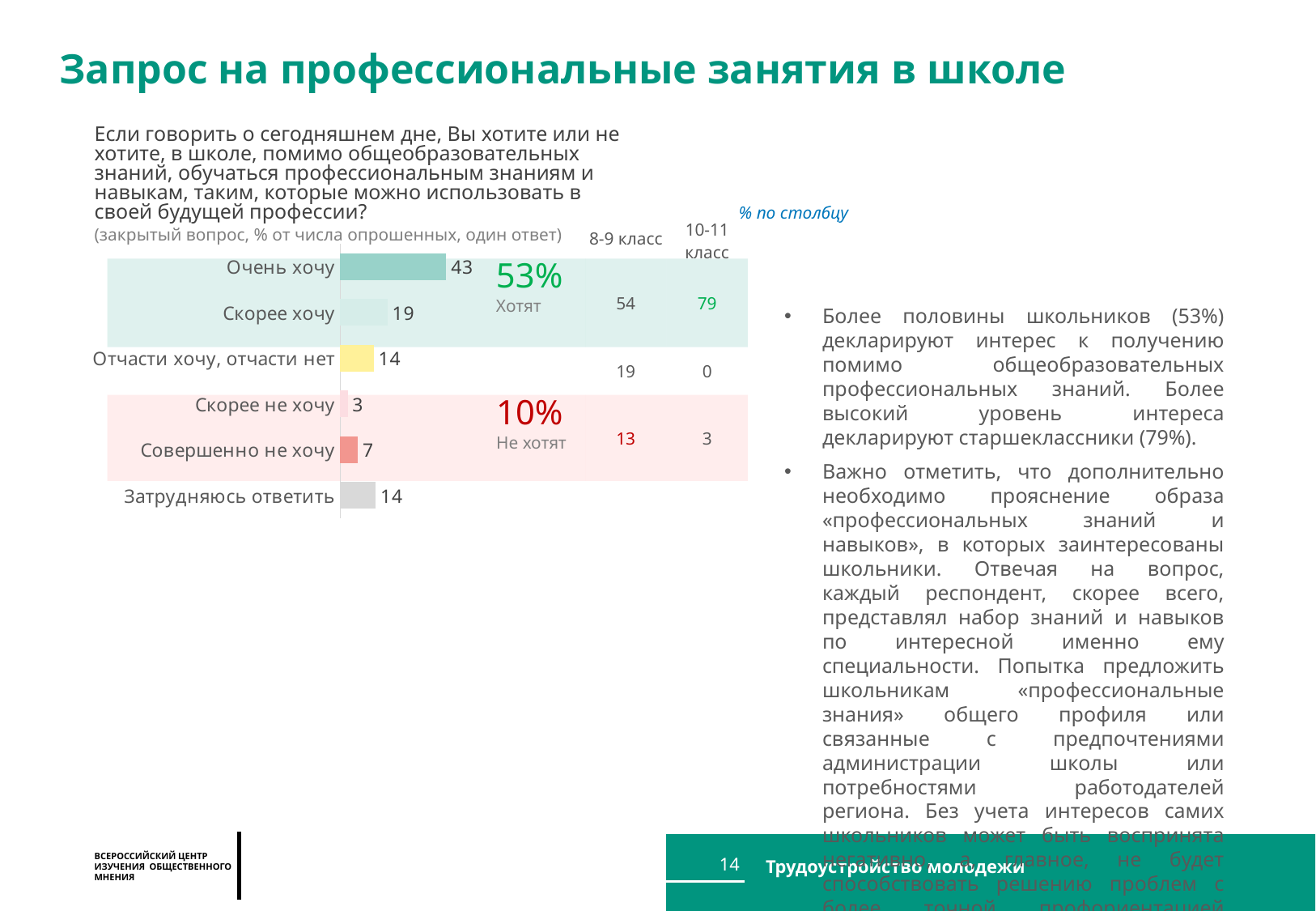
What value is shown for "Совершенно не хочу" in the bar chart? 7 Which category has the highest value in the bar chart? Очень хочу What is the combined share of respondents who want professional training ("Хотят") shown next to the chart? 53% How many categories are shown in the bar chart? 6 What kind of chart is shown on the slide? Bar chart Which category has the lowest value in the bar chart? Скорее не хочу Which is larger: the value for "Совершенно не хочу" or the value for "Скорее не хочу"? Совершенно не хочу What is the difference between the values for "Очень хочу" and "Скорее хочу"? 24 What value is shown for "Скорее хочу" in the bar chart? 19 In the table next to the chart, what is the "Хотят" value for 10-11 класс? 79 What value is shown for "Очень хочу" in the bar chart? 43 In the table next to the chart, what is the "Не хотят" value for 8-9 класс? 13